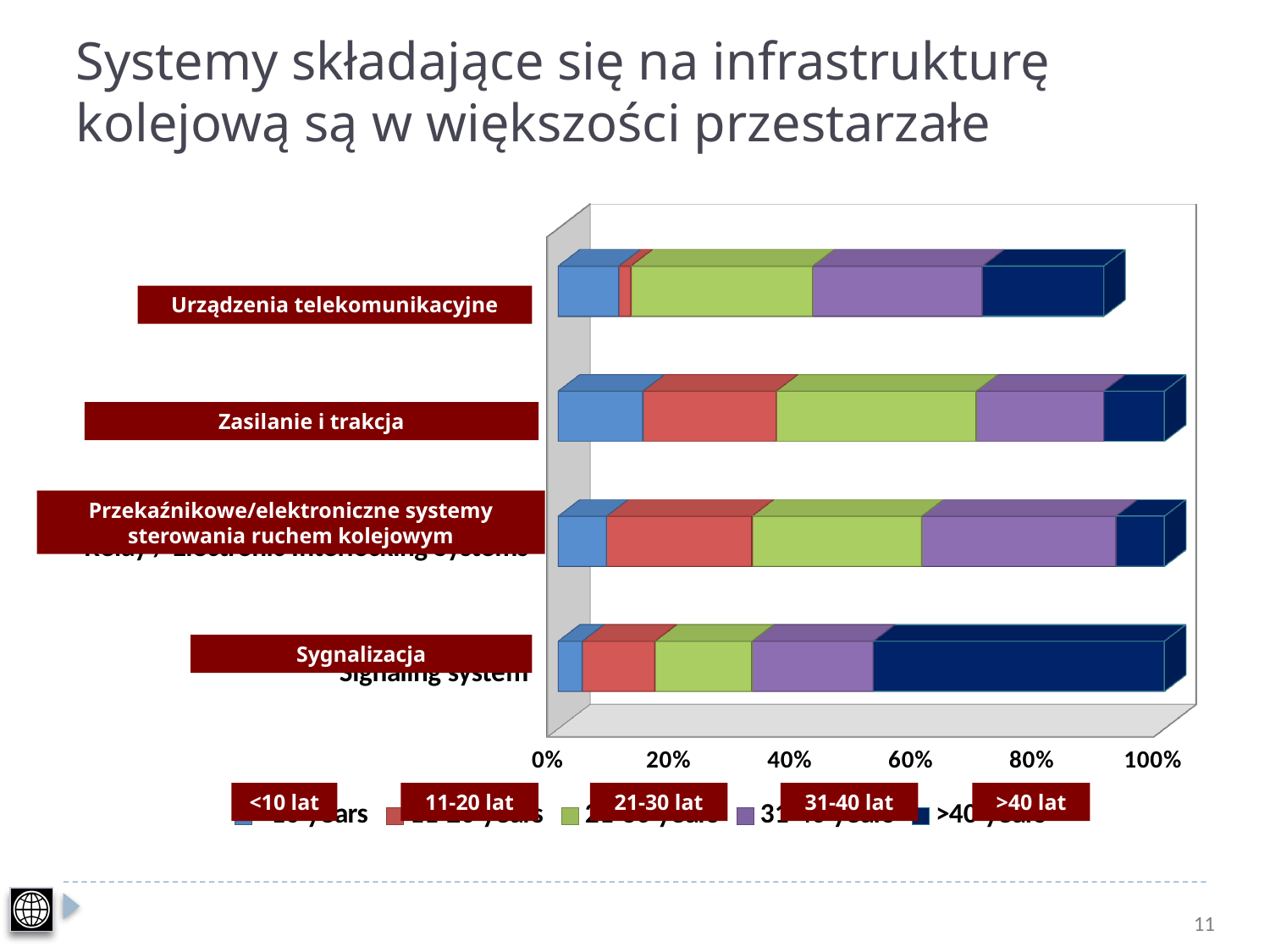
Which category has the smallest share of the '<10 lat' age group? Sygnalizacja Which category has the largest share of the '>40 lat' age group? Sygnalizacja Which age group series is shown in dark navy blue in the legend? >40 lat Is the '11-20 lat' share for Urządzenia telekomunikacyjne greater or less than 20%? less Which category has the smallest share of the '11-20 lat' age group? Urządzenia telekomunikacyjne What kind of chart is shown on the slide? Stacked bar chart Which has a larger '>40 lat' share: Sygnalizacja or Urządzenia telekomunikacyjne? Sygnalizacja Is the '>40 lat' share for Zasilanie i trakcja greater or less than 20%? less Is the '>40 lat' share for Sygnalizacja greater or less than 40%? greater Which has a larger '<10 lat' share: Zasilanie i trakcja or Sygnalizacja? Zasilanie i trakcja How many categories (systems) are plotted in the chart? 4 How many series does the chart legend list? 5